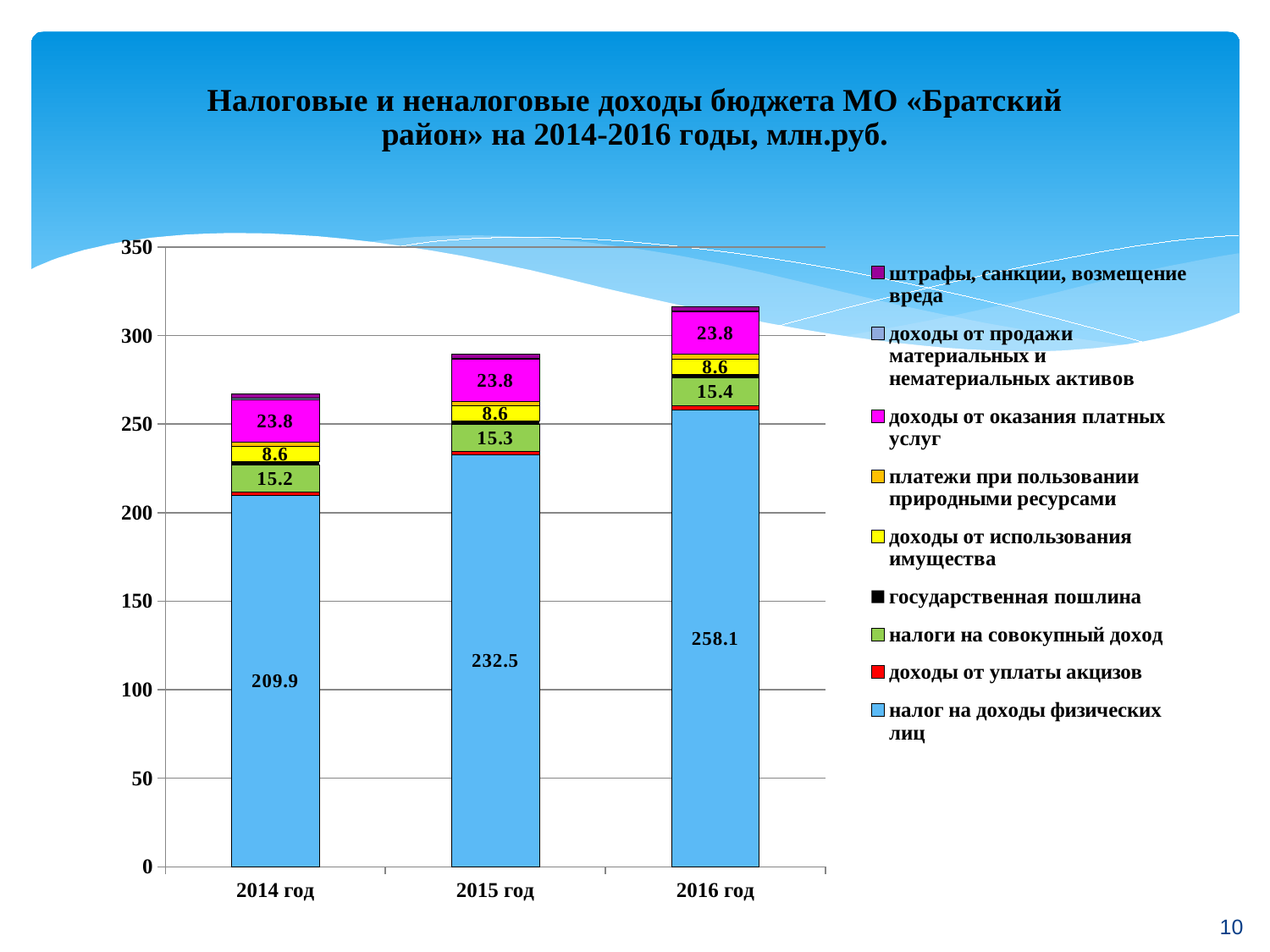
How many years (categories) are shown on the x axis? 3 What type of chart is shown on the slide? Stacked bar chart What is the value of доходы от использования имущества for 2014 год? 8.6 How many series does the legend list? 9 In which year is налог на доходы физических лиц the lowest? 2014 год In which year is налог на доходы физических лиц the highest? 2016 год What is the value of налог на доходы физических лиц for 2014 год? 209.9 What is the value of налоги на совокупный доход for 2015 год? 15.3 What is the value of доходы от оказания платных услуг for 2016 год? 23.8 What is the value of налог на доходы физических лиц for 2016 год? 258.1 What is the difference in налог на доходы физических лиц between 2016 год and 2014 год? 48.2 Which is larger: налог на доходы физических лиц in 2015 год or in 2014 год? 2015 год